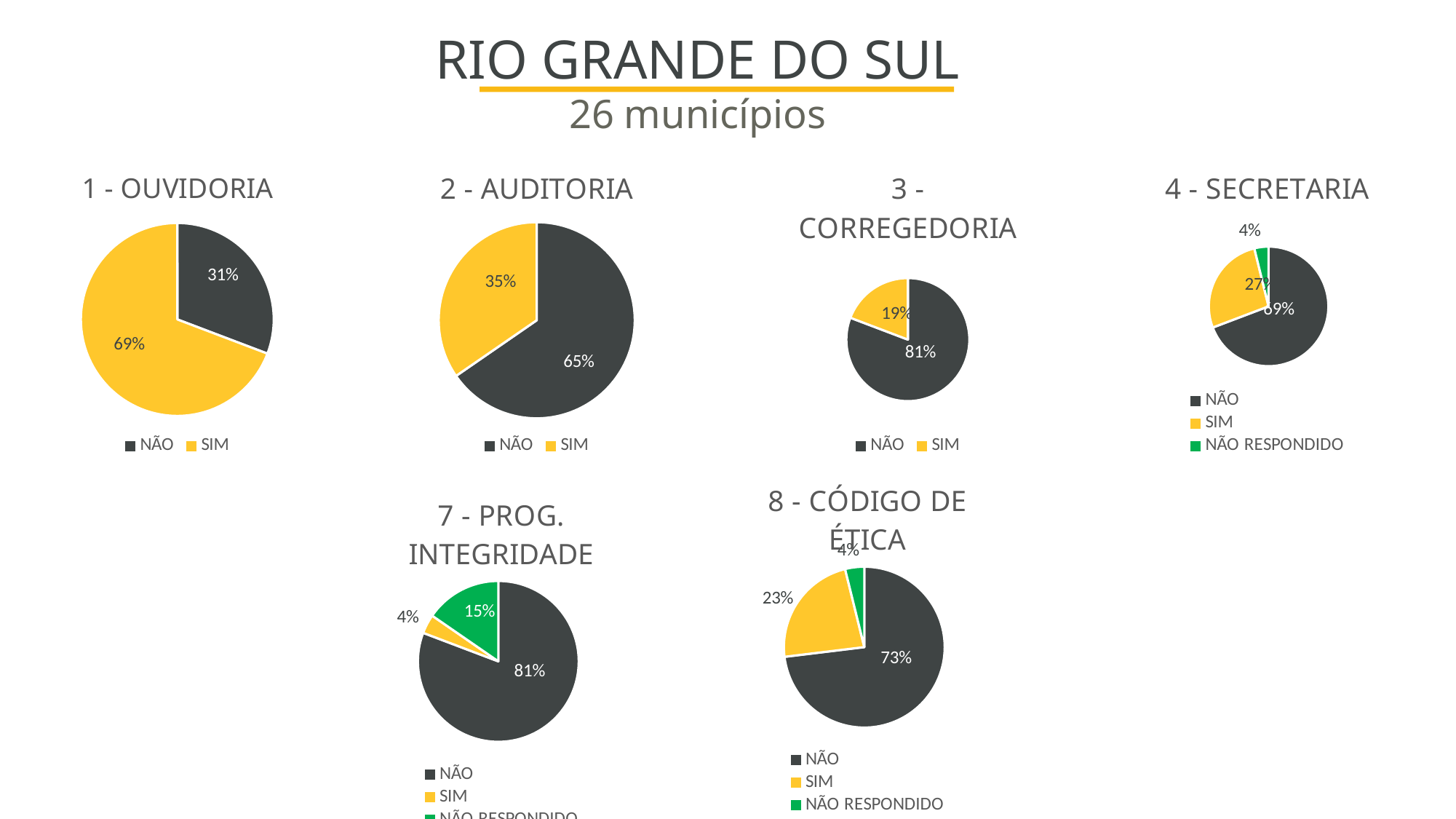
In the '2 - AUDITORIA' pie chart, what percentage is shown for NÃO? 65% In the '4 - SECRETARIA' pie chart, what percentage is shown for NÃO RESPONDIDO? 4% In the '1 - OUVIDORIA' pie chart, what percentage is shown for NÃO? 31% In the '1 - OUVIDORIA' pie chart, what percentage is shown for SIM? 69% In the '8 - CÓDIGO DE ÉTICA' pie chart, what percentage is shown for SIM? 23% What type of chart is used for '8 - CÓDIGO DE ÉTICA'? Pie chart In the '3 - CORREGEDORIA' pie chart, what percentage is shown for SIM? 19% In the '3 - CORREGEDORIA' pie chart, what is the difference between the NÃO and SIM percentages? 62% In the '7 - PROG. INTEGRIDADE' pie chart, what percentage is shown for NÃO RESPONDIDO? 15% How many entries does the legend of the '4 - SECRETARIA' pie chart list? 3 In the '7 - PROG. INTEGRIDADE' pie chart, which slice is the smallest? SIM In the '2 - AUDITORIA' pie chart, which slice is larger, NÃO or SIM? NÃO